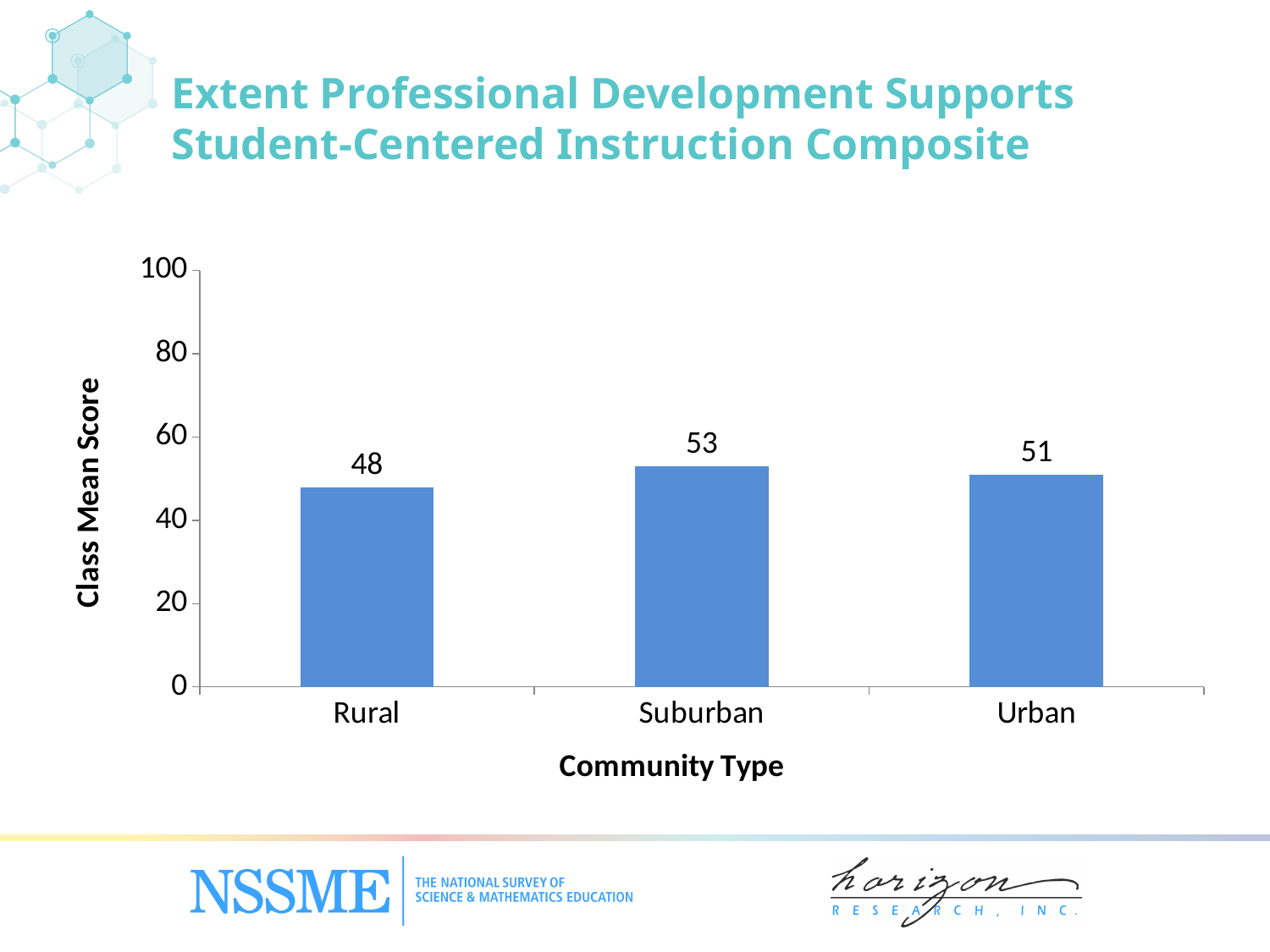
What is the difference between the Suburban and Rural class mean scores? 5 Which community type has the lowest class mean score? Rural What is the class mean score for Rural? 48 Which community type has the highest class mean score? Suburban Which has a higher class mean score, Urban or Rural? Urban What is the difference between the Urban and Rural class mean scores? 3 What kind of chart is shown on the slide? bar chart What is the label of the vertical axis? Class Mean Score How many community types are shown on the chart? 3 Is the value for Suburban greater or less than 60? less What is the class mean score for Suburban? 53 What is the class mean score for Urban? 51